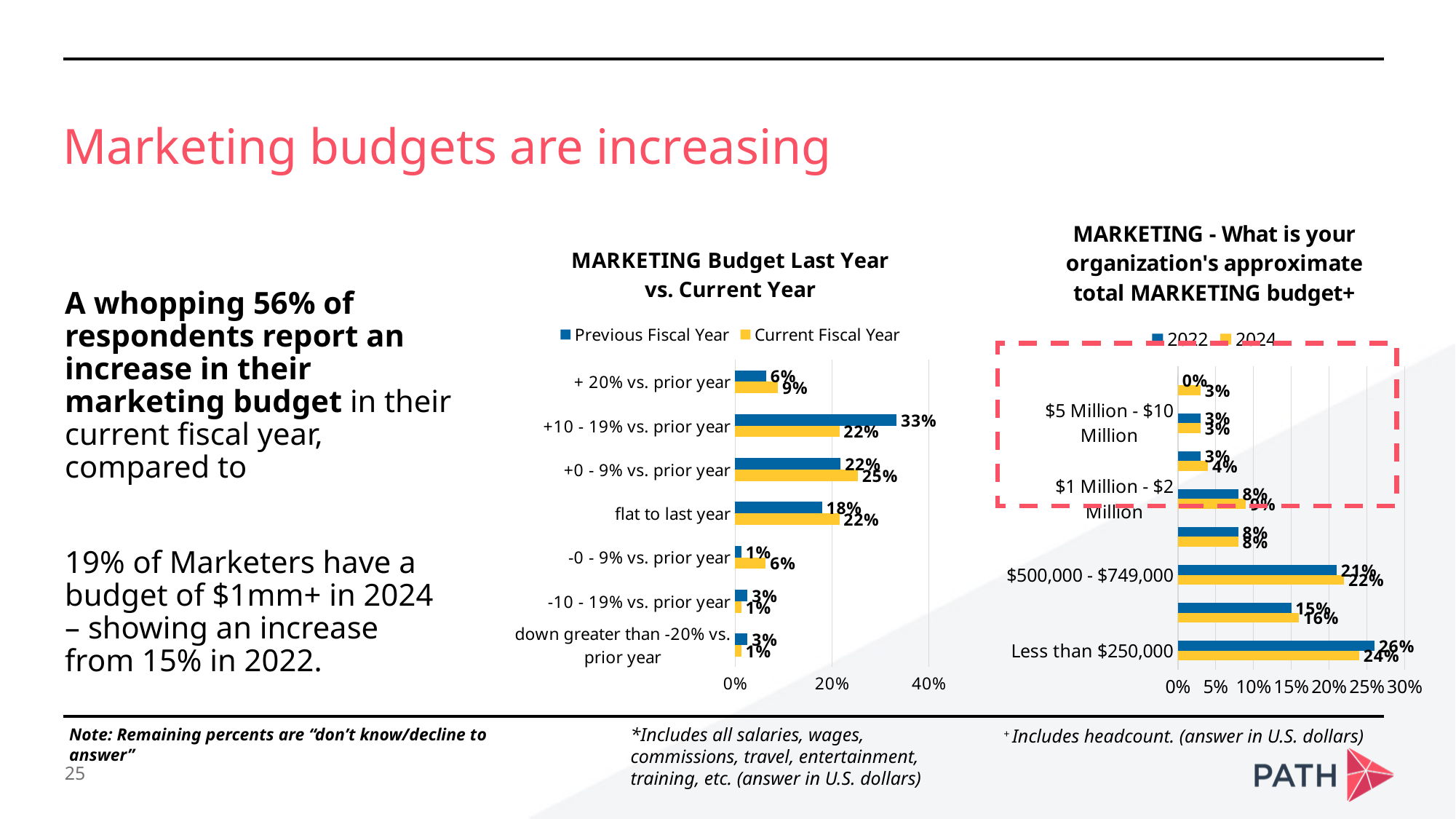
How many categories are shown in the 'MARKETING Budget Last Year vs. Current Year' chart? 7 In the 'MARKETING Budget Last Year vs. Current Year' chart, which is larger for '+0 - 9% vs. prior year': the Previous Fiscal Year value or the Current Fiscal Year value? Current Fiscal Year In the 'MARKETING - What is your organization's approximate total MARKETING budget' chart, what is the 2024 value for '$500,000 - $749,000'? 22% In the 'MARKETING - What is your organization's approximate total MARKETING budget' chart, which is larger for 'Less than $250,000': the 2022 value or the 2024 value? 2022 In the 'MARKETING - What is your organization's approximate total MARKETING budget' chart, what is the 2022 value for 'Less than $250,000'? 26% In the 'MARKETING Budget Last Year vs. Current Year' chart, which category has the highest Previous Fiscal Year value? +10 - 19% vs. prior year In the 'MARKETING Budget Last Year vs. Current Year' chart, what is the Current Fiscal Year value for 'flat to last year'? 22% How many series does the legend of the 'MARKETING Budget Last Year vs. Current Year' chart list? 2 In the 'MARKETING Budget Last Year vs. Current Year' chart, what is the Previous Fiscal Year value for '+10 - 19% vs. prior year'? 33% What are the two series listed in the legend of the 'MARKETING - What is your organization's approximate total MARKETING budget' chart? 2022 and 2024 What type of chart is the 'MARKETING Budget Last Year vs. Current Year' chart? Bar chart In the 'MARKETING Budget Last Year vs. Current Year' chart, what is the difference between the Previous Fiscal Year and Current Fiscal Year values for '+10 - 19% vs. prior year'? 11%